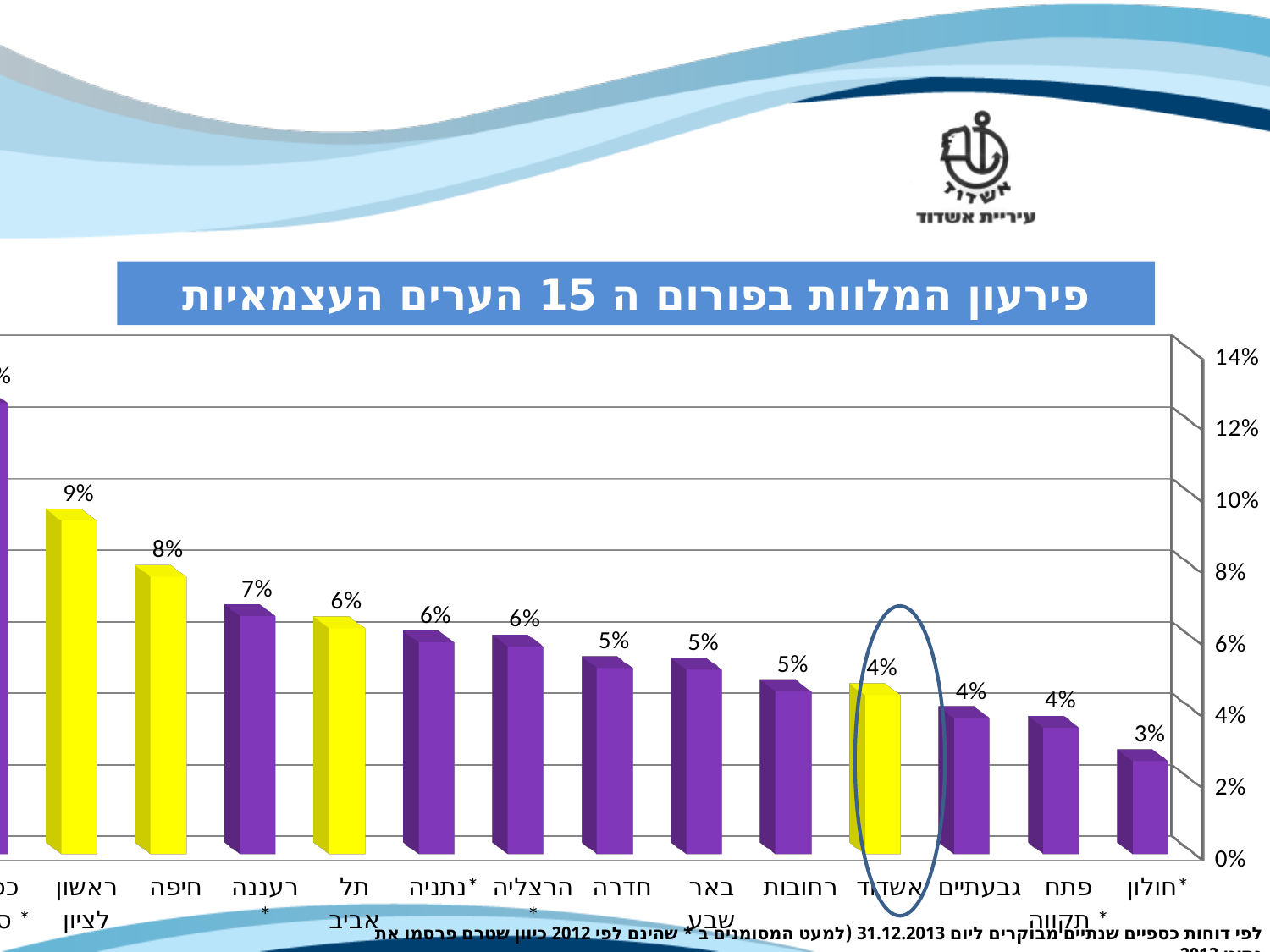
What is the difference between the values for רעננה and אשדוד? 3% What is the value for רעננה? 7% What is the value for חולון? 3% What colour is the bar for אשדוד? yellow What kind of chart is shown on the slide? bar chart What is the value for חיפה? 8% What is the value for אשדוד? 4% What is the value for ראשון לציון? 9% Which is larger, the value for חיפה or the value for חדרה? חיפה What is the difference between the values for ראשון לציון and חיפה? 1% Which city has the lowest value on the chart? חולון Is the value for ראשון לציון greater or less than 8%? greater